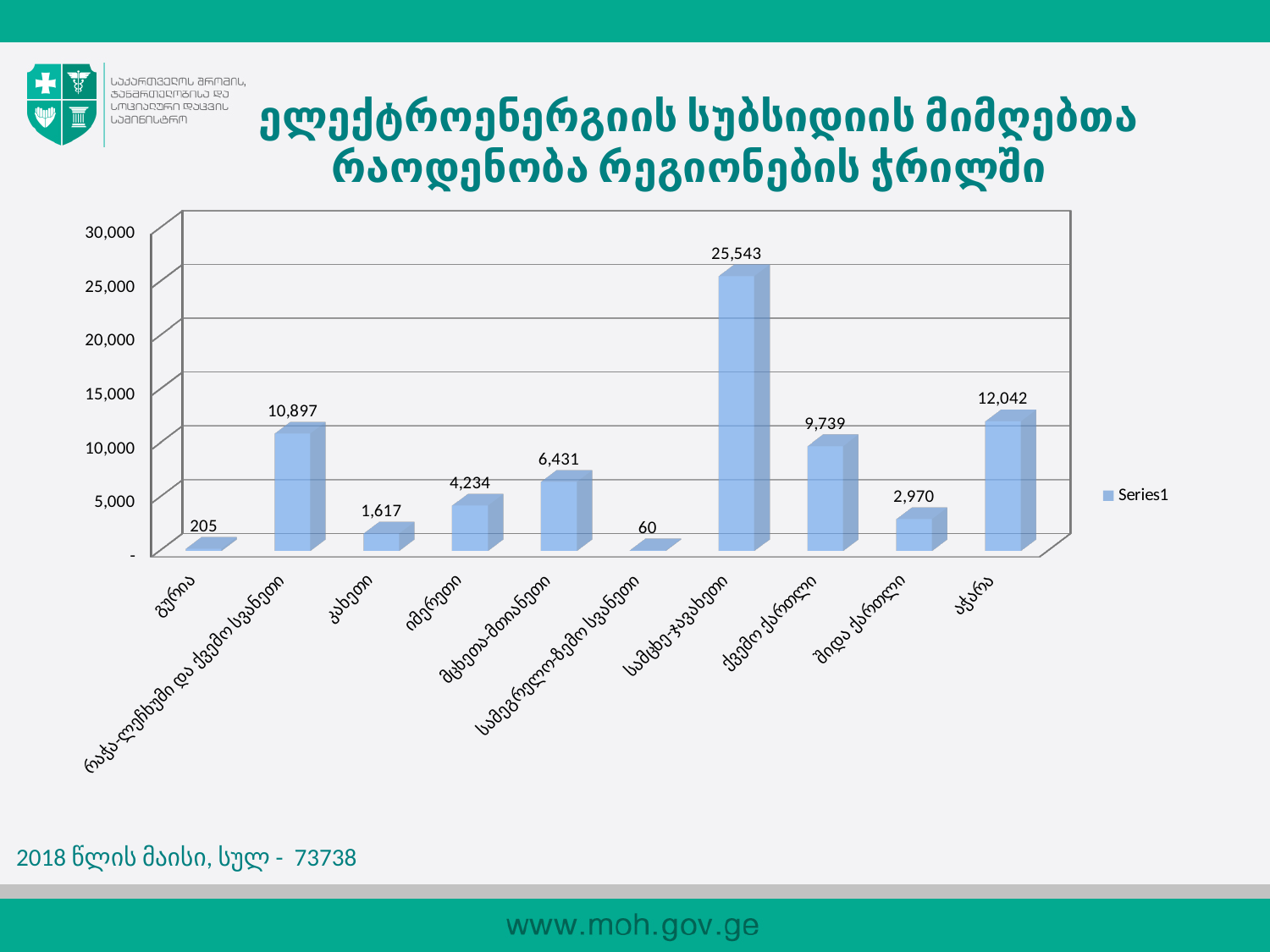
What is the difference between the values for აჭარა and ქვემო ქართლი? 2,303 Which region has the highest value? სამცხე-ჯავახეთი Is the value for რაჭა-ლეჩხუმი და ქვემო სვანეთი greater or less than 10,000? greater What is the legend entry shown on the chart? Series1 How many series does the legend list? 1 What is the value for სამცხე-ჯავახეთი? 25,543 Which region has the lowest value? სამეგრელო-ზემო სვანეთი Which is larger, the value for იმერეთი or the value for მცხეთა-მთიანეთი? მცხეთა-მთიანეთი What kind of chart is shown on the slide? bar chart What is the value for აჭარა? 12,042 How many regions are shown on the chart? 10 What is the value for გურია? 205